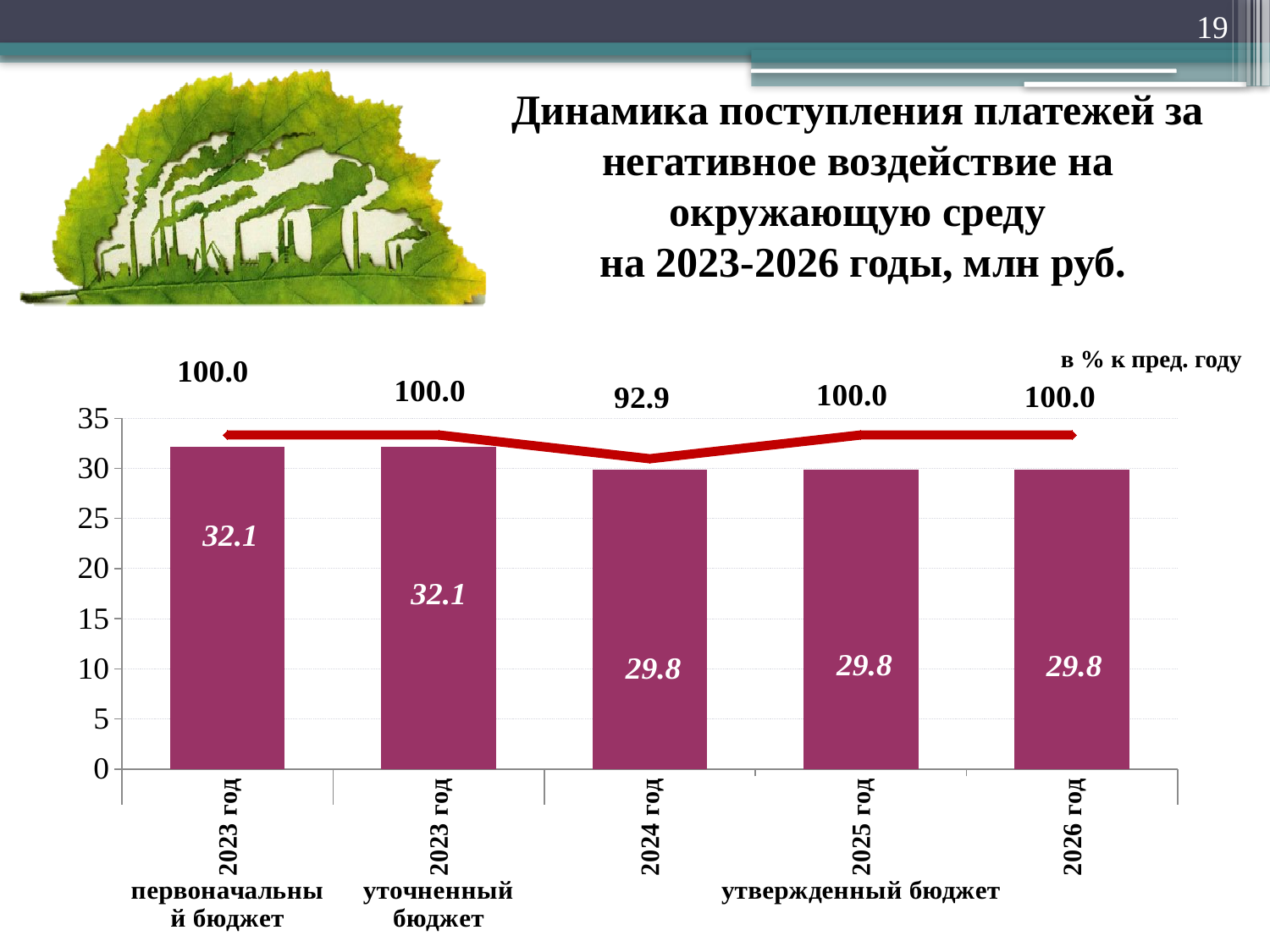
What percentage to the previous year is shown above the 2025 год bar? 100.0 What kind of chart is shown on the slide? combination bar and line chart What is the value for 2026 год? 29.8 Which is larger: the value for 2023 год (первоначальный бюджет) or the value for 2025 год? 2023 год (первоначальный бюджет) What is the difference between the value for 2023 год (уточненный бюджет) and the value for 2024 год? 2.3 What is the value for 2024 год (утвержденный бюджет)? 29.8 How many bars are plotted in the chart? 5 Do the bar values rise or fall from 2023 год (уточненный бюджет) to 2024 год? fall What is the value for 2023 год (первоначальный бюджет)? 32.1 Is the value for 2025 год greater or less than 30? less What percentage to the previous year (в % к пред. году) is shown above the 2024 год bar? 92.9 Is the value for 2023 год (уточненный бюджет) greater or less than 30? greater